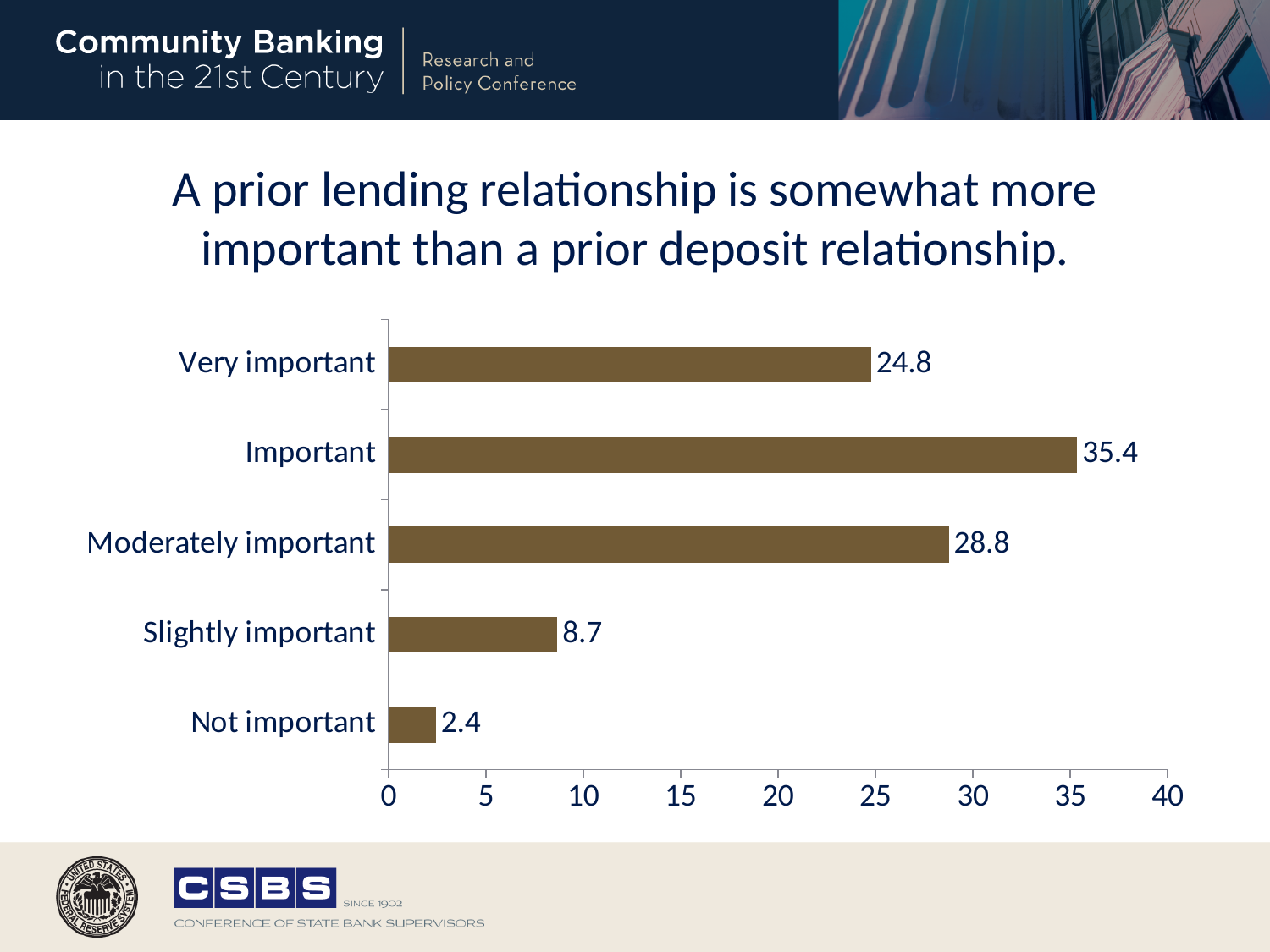
Which category has the lowest value? Not important What is the value for Moderately important? 28.8 What is the value for Very important? 24.8 What is the value for Important? 35.4 How many categories are shown in the chart? 5 Is the value for Slightly important greater or less than 10? less What is the difference between the values for Important and Very important? 10.6 What is the value for Not important? 2.4 Which category has the highest value? Important What is the value for Slightly important? 8.7 Which is larger, the value for Moderately important or the value for Very important? Moderately important What kind of chart is shown on the slide? bar chart